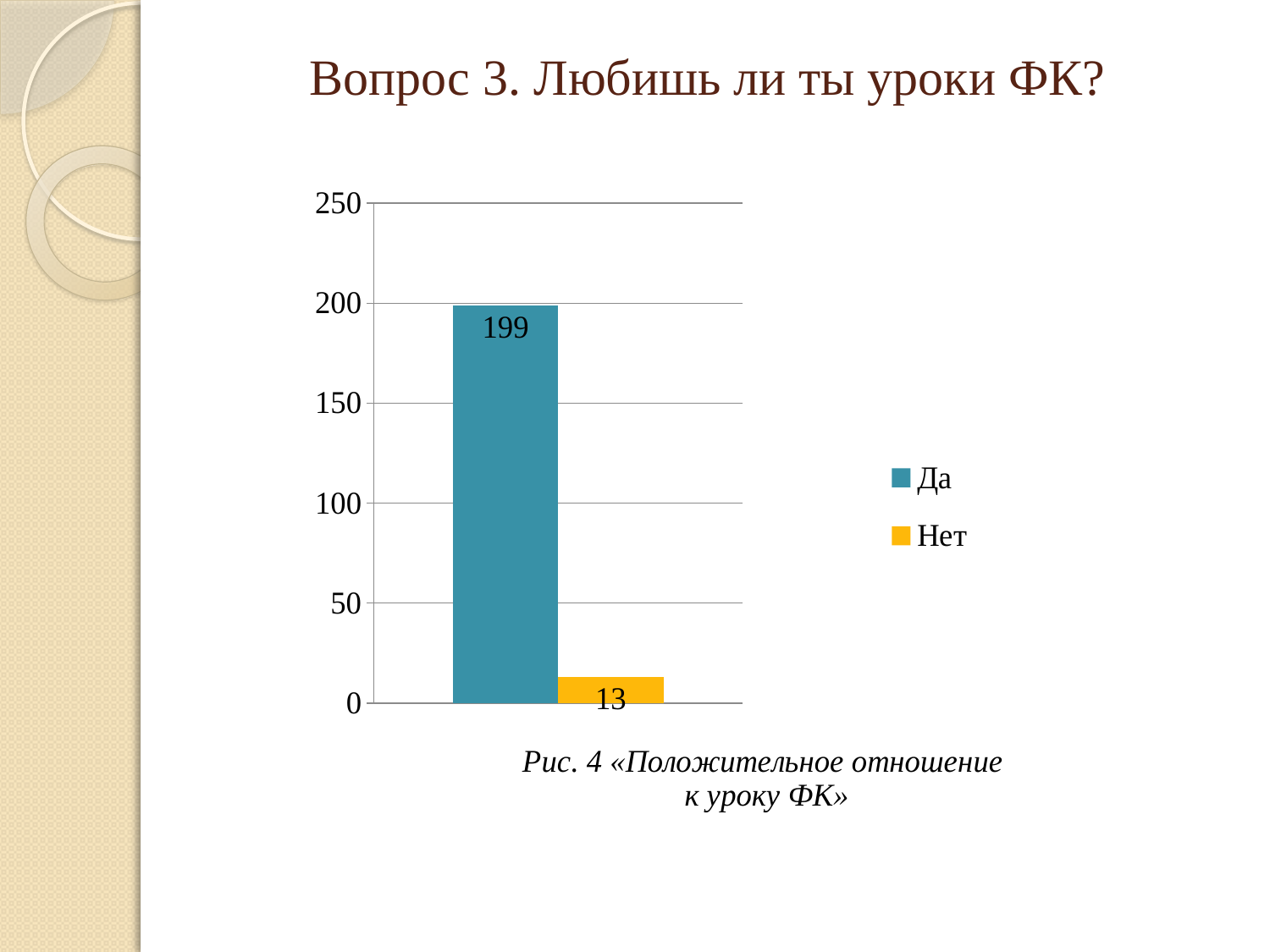
What is the value for "Да"? 199 What is the difference between the values for "Да" and "Нет"? 186 What is the total of the two values shown in the chart? 212 What is the value for "Нет"? 13 Is the value for "Нет" greater or less than 50? less Which series has the lowest value? Нет Which series has the highest value? Да Is the value for "Да" greater or less than 150? greater How many series does the legend list? 2 Which is larger, the value for "Да" or the value for "Нет"? Да What colour is the bar for "Нет"? yellow/orange What kind of chart is shown on the slide? bar chart